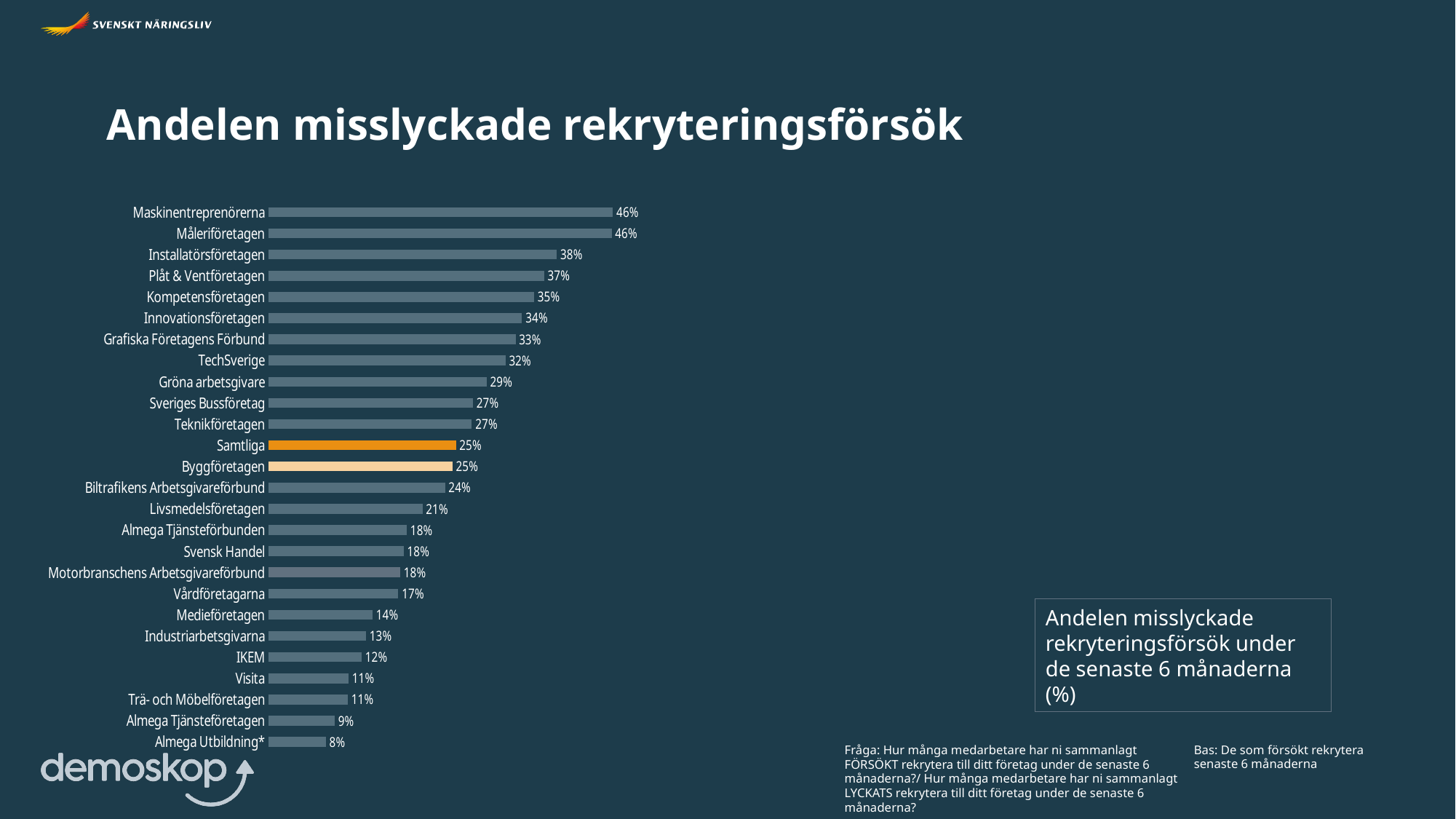
Which category has the lowest value? Almega Utbildning* What is the title of the slide? Andelen misslyckade rekryteringsförsök What is the value for Installatörsföretagen? 38% What is the difference between the values for Maskinentreprenörerna and Byggföretagen? 21 percentage points What is the highest value shown in the chart? 46% What is the value for IKEM? 12% What is the value for Samtliga? 25% Which is larger, the value for TechSverige or the value for Gröna arbetsgivare? TechSverige How many categories are shown in the chart? 26 Which category's bar is coloured dark orange? Samtliga What is the value for Svensk Handel? 18% What kind of chart is shown on the slide? Bar chart